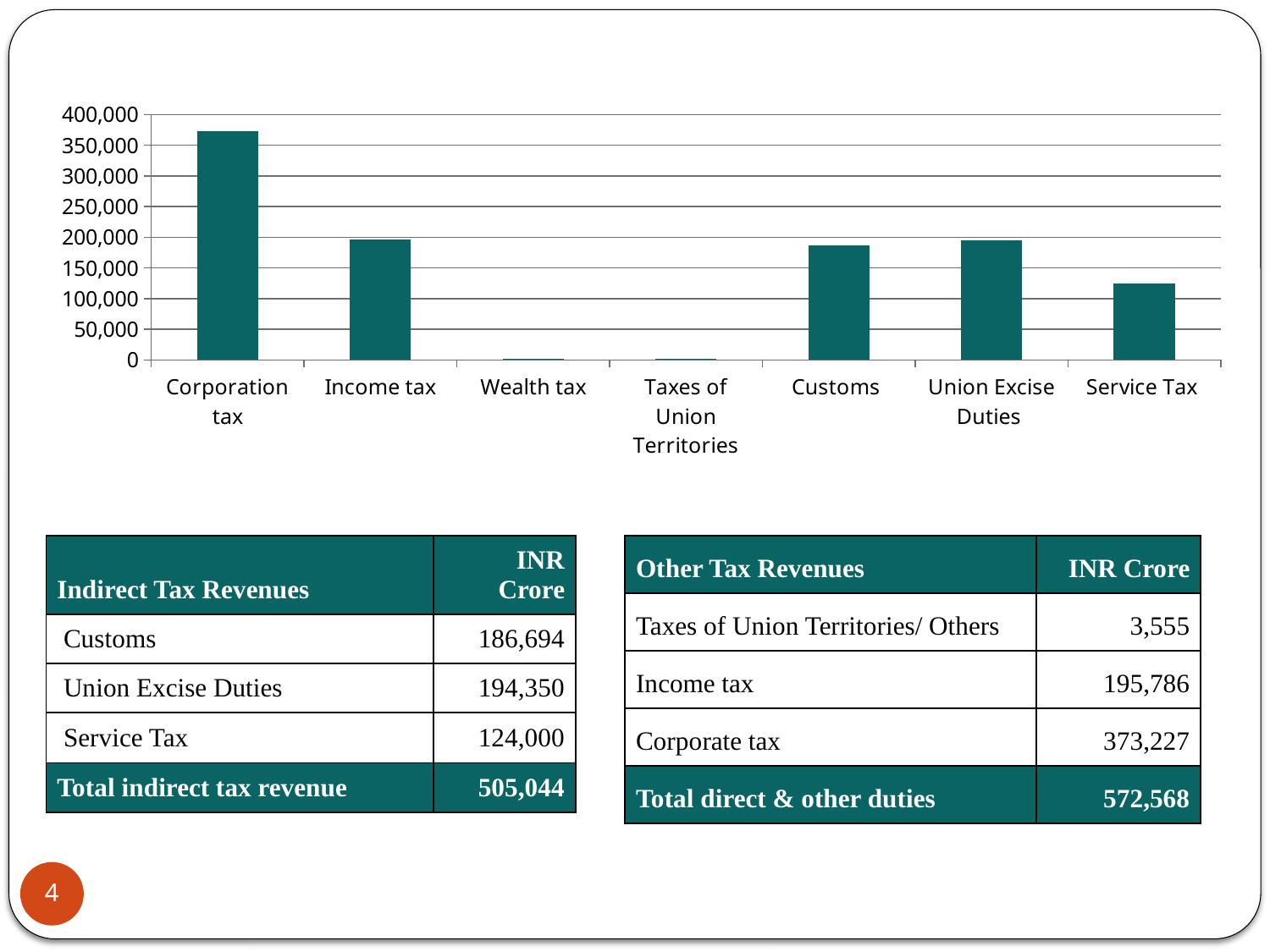
Which category has the highest bar in the chart? Corporation tax Is the value for Customs greater or less than 150,000? greater Is the value for Service Tax greater or less than 100,000? greater Is the value for Wealth tax greater or less than 50,000? less What is the highest value shown on the chart's vertical axis? 400,000 What kind of chart is shown on the slide? bar chart How many categories are shown on the x axis of the chart? 7 Which is larger in the chart, Corporation tax or Income tax? Corporation tax Which is larger in the chart, Customs or Service Tax? Customs